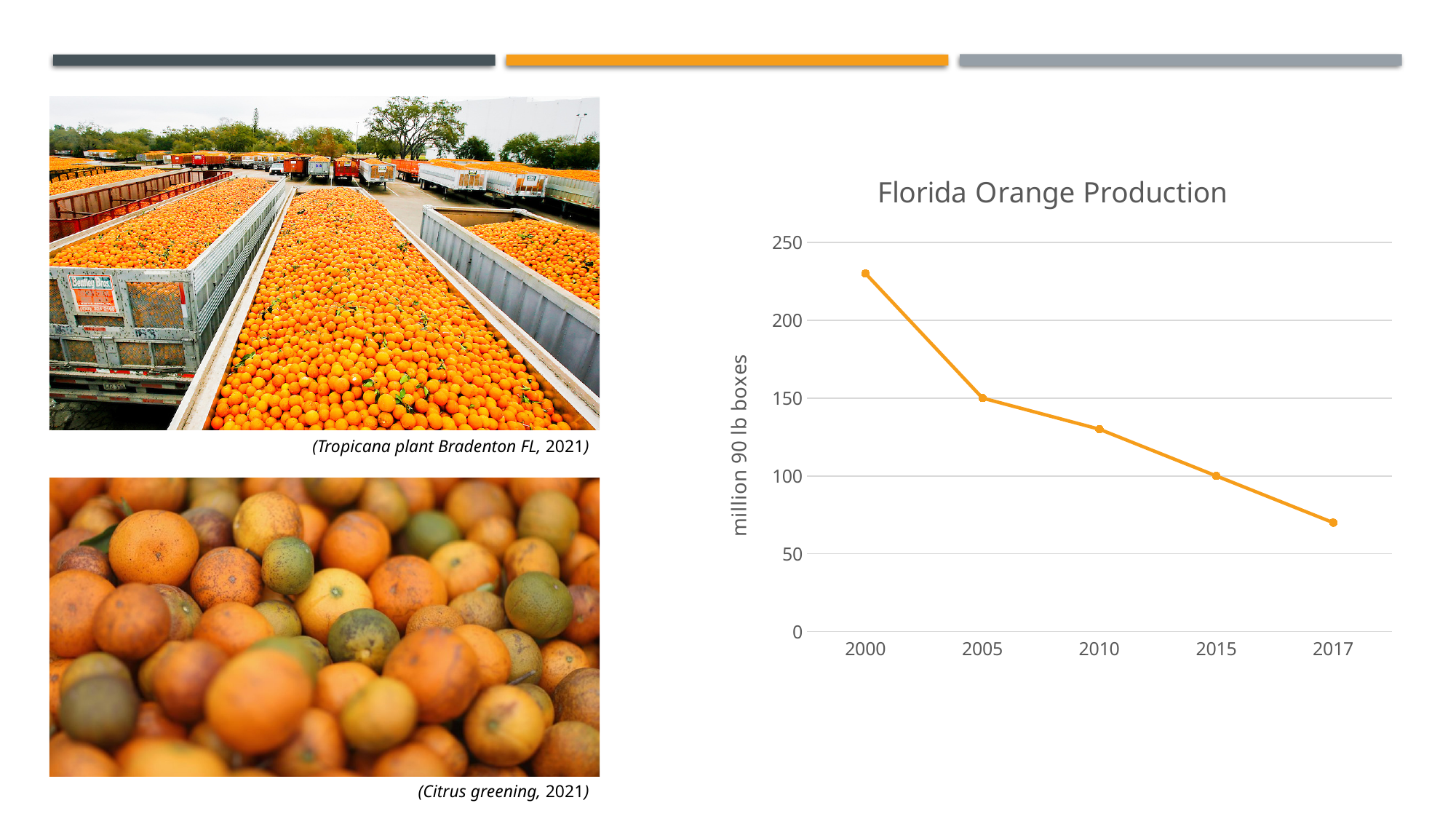
What is the label on the vertical axis of the chart? million 90 lb boxes Is the value for 2000 greater or less than 200? greater What type of chart is shown on the slide? line chart Which year has the larger production, 2005 or 2015? 2005 What is the title of the chart? Florida Orange Production Is the value for 2015 greater or less than 150? less How many data points are plotted on the line? 5 Is the value for 2017 greater or less than 50? greater Which year has the highest Florida orange production? 2000 Does Florida orange production rise or fall from 2000 to 2017? fall Which year has the lowest Florida orange production? 2017